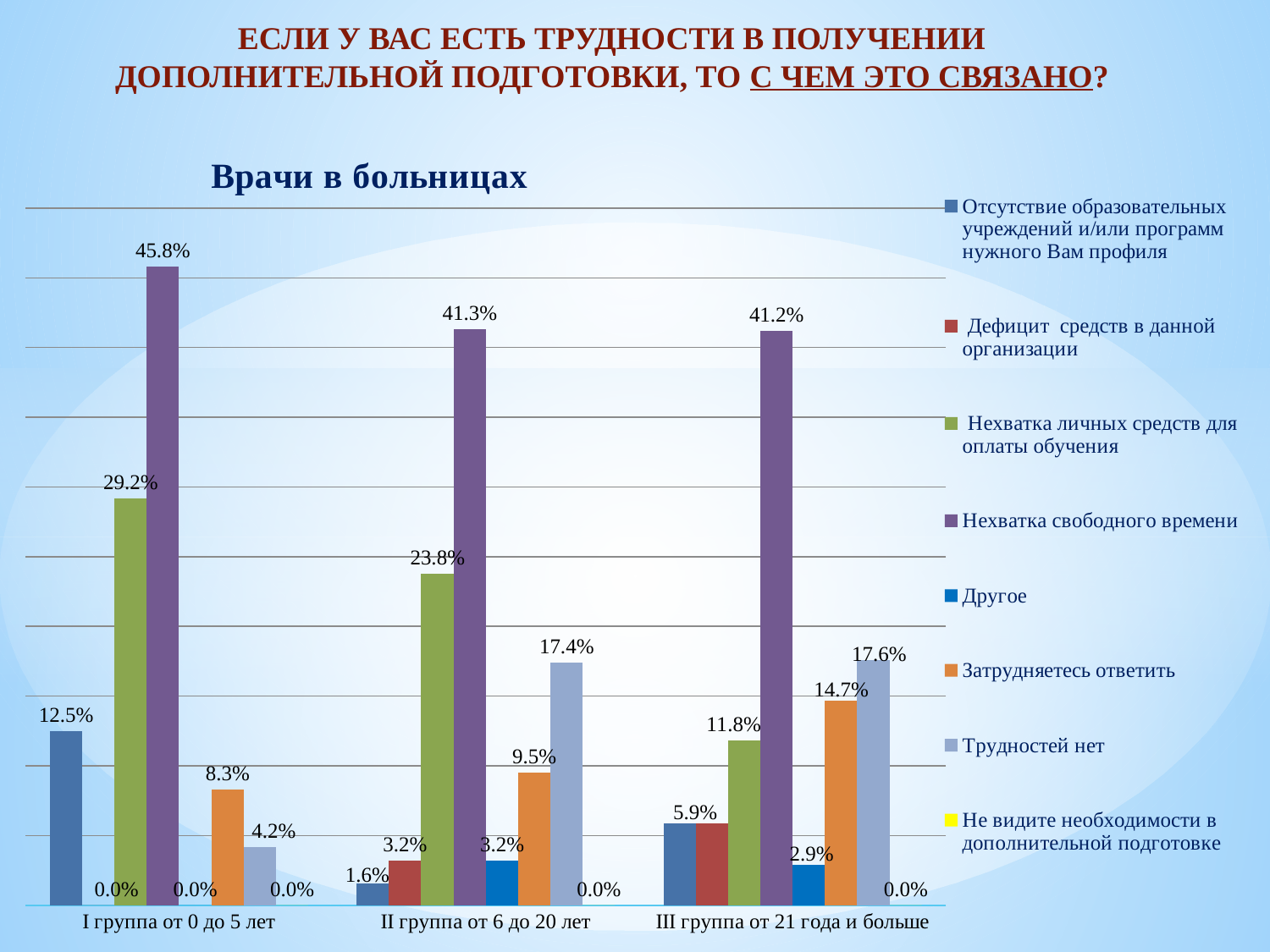
What is the value for 'Нехватка свободного времени' in 'I группа от 0 до 5 лет'? 45.8% What is the value for 'Затрудняетесь ответить' in 'III группа от 21 года и больше'? 14.7% What is the value for 'Трудностей нет' in 'II группа от 6 до 20 лет'? 17.4% Which group has the highest value for 'Нехватка свободного времени'? I группа от 0 до 5 лет What is the difference between 'Нехватка свободного времени' in 'I группа от 0 до 5 лет' and in 'II группа от 6 до 20 лет'? 4.5 percentage points Which group has the larger value for 'Нехватка личных средств для оплаты обучения': 'I группа от 0 до 5 лет' or 'II группа от 6 до 20 лет'? I группа от 0 до 5 лет How many groups (categories) are shown on the x axis? 3 What kind of chart is shown on the slide? Bar chart Which series has the highest value in 'II группа от 6 до 20 лет'? Нехватка свободного времени What is the difference between 'Затрудняетесь ответить' in 'III группа от 21 года и больше' and in 'II группа от 6 до 20 лет'? 5.2 percentage points Does the value for 'Нехватка личных средств для оплаты обучения' rise or fall from 'I группа' to 'III группа'? Falls How many series does the legend list? 8